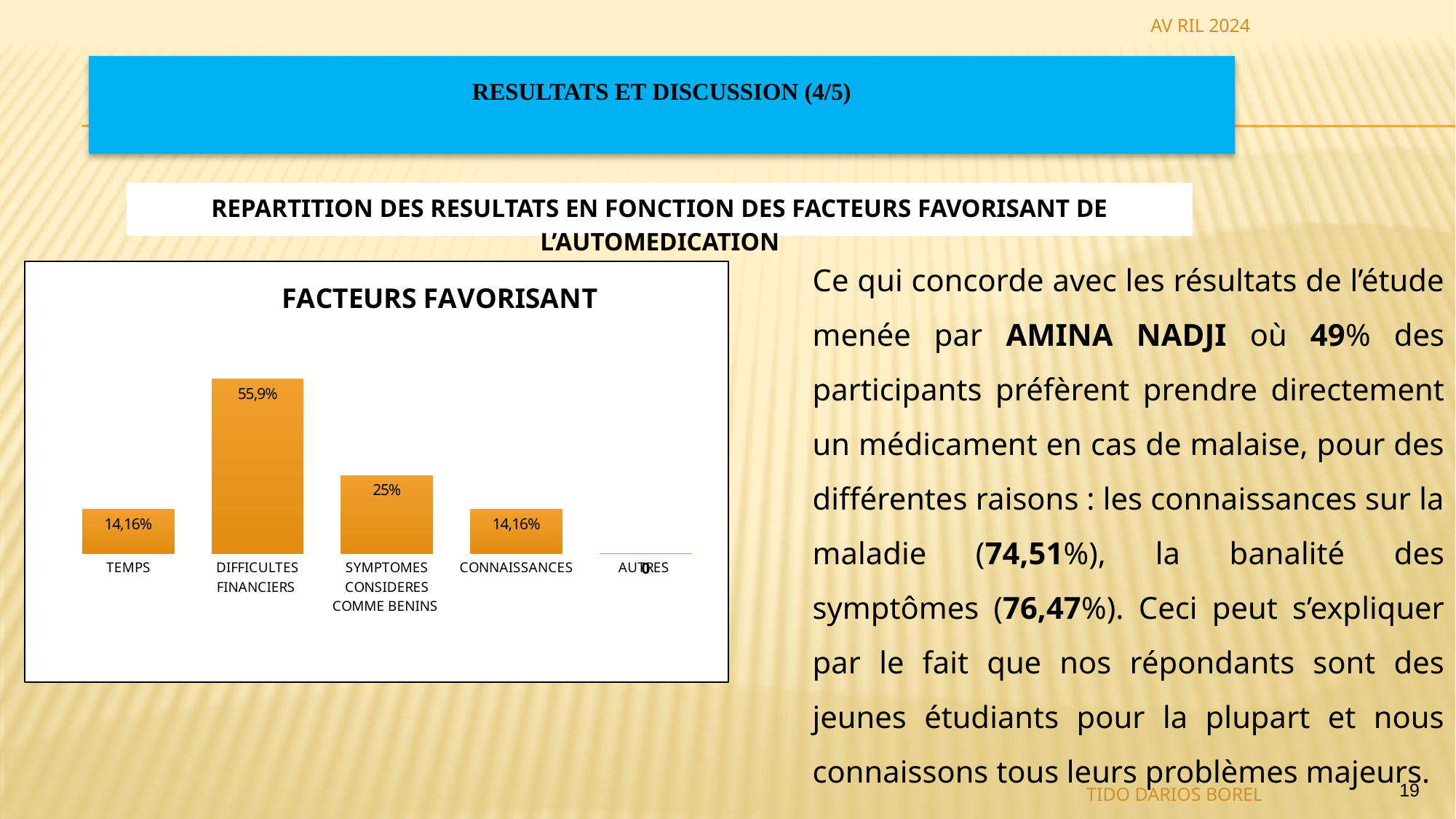
What is the value for CONNAISSANCES in the FACTEURS FAVORISANT chart? 14,16% Which category has the lowest value in the FACTEURS FAVORISANT chart? AUTRES What is the title of the chart on the slide? FACTEURS FAVORISANT What is the value for SYMPTOMES CONSIDERES COMME BENINS in the FACTEURS FAVORISANT chart? 25% Which category has the highest value in the FACTEURS FAVORISANT chart? DIFFICULTES FINANCIERS What is the value for DIFFICULTES FINANCIERS in the FACTEURS FAVORISANT chart? 55,9% How many categories are shown in the FACTEURS FAVORISANT chart? 5 What kind of chart is the FACTEURS FAVORISANT chart? Bar chart What is the value for AUTRES in the FACTEURS FAVORISANT chart? 0 What is the difference between the values for DIFFICULTES FINANCIERS and SYMPTOMES CONSIDERES COMME BENINS in the FACTEURS FAVORISANT chart? 30,9% What is the value for TEMPS in the FACTEURS FAVORISANT chart? 14,16% Which is larger in the FACTEURS FAVORISANT chart: SYMPTOMES CONSIDERES COMME BENINS or CONNAISSANCES? SYMPTOMES CONSIDERES COMME BENINS